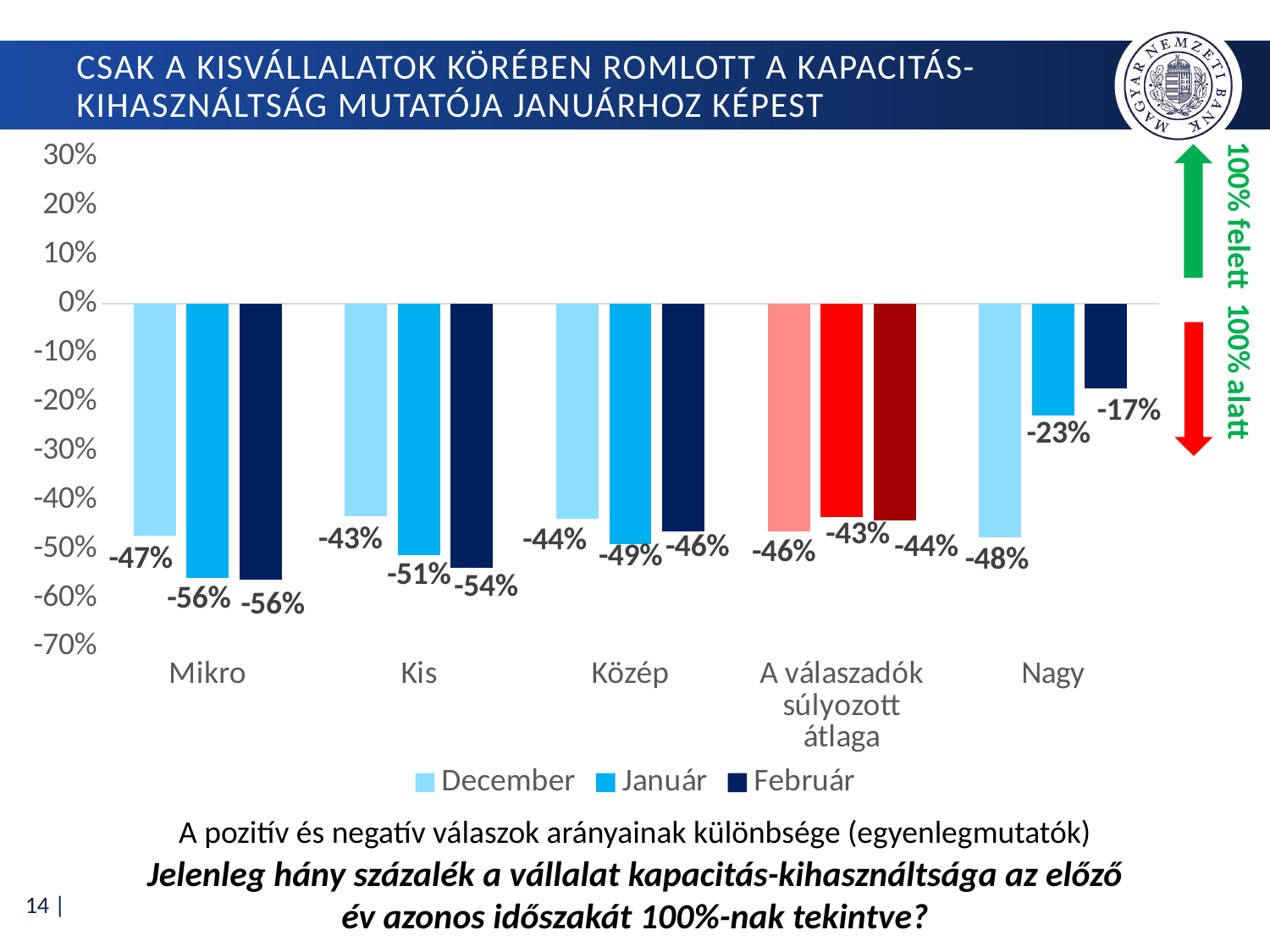
What is the Január value for Nagy? -23% Which category has the highest Február value? Nagy What is the difference between the Január and Február values for Nagy? 6 percentage points What is the Február value for A válaszadók súlyozott átlaga? -44% Which is larger for Közép, the December value or the Január value? December What are the three series listed in the legend? December, Január, Február What is the Február value for Kis? -54% Which category has the lowest Január value? Mikro What kind of chart is shown on the slide? Bar chart How many categories are shown on the x axis? 5 What is the December value for Mikro? -47% How many series does the legend list? 3